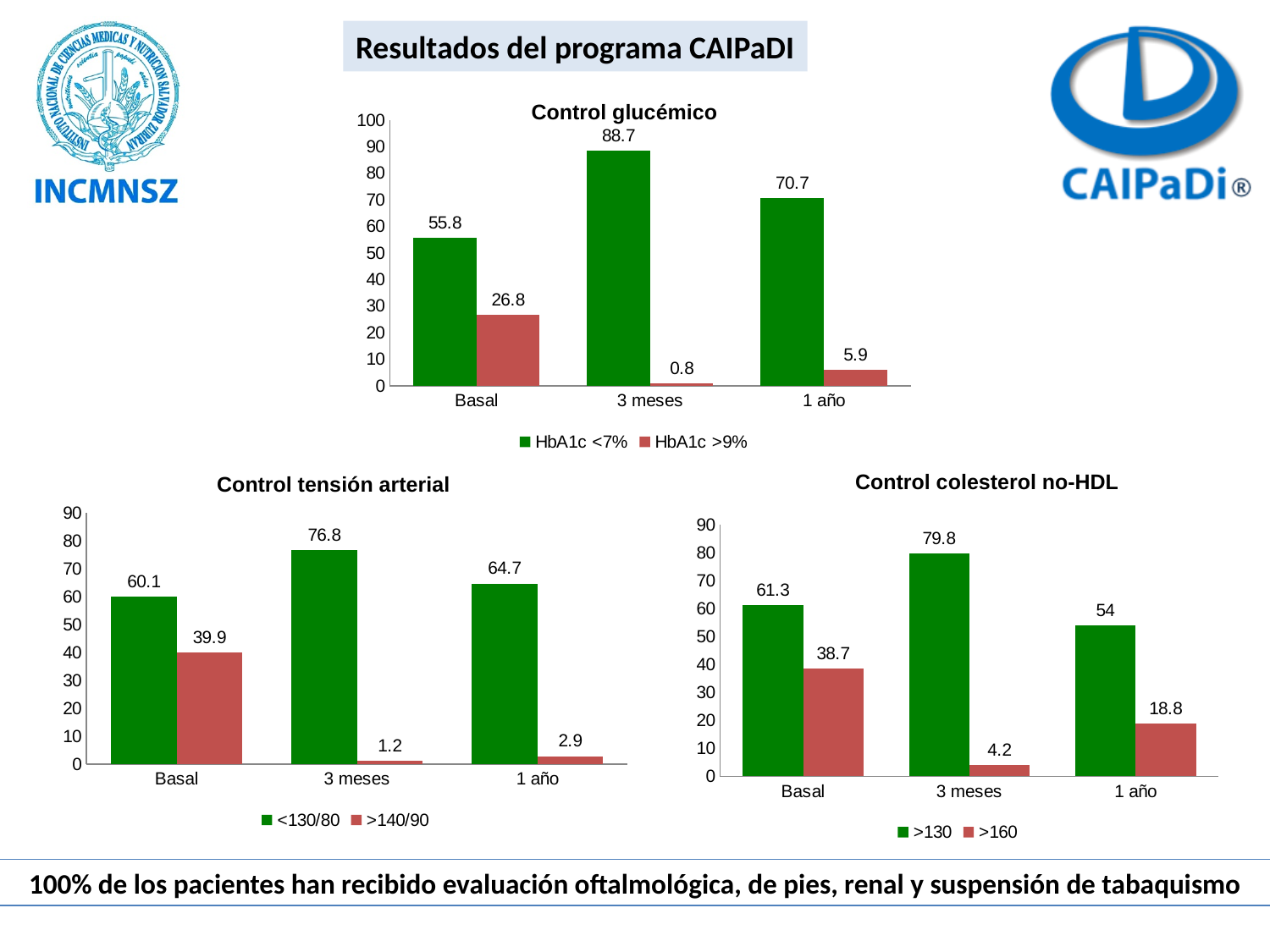
In the 'Control tensión arterial' chart, is the >140/90 value at Basal larger or smaller than the >140/90 value at 1 año? larger How many series does the legend of the 'Control colesterol no-HDL' chart list? 2 In the 'Control glucémico' chart, what is the value of HbA1c <7% at 3 meses? 88.7 In the 'Control tensión arterial' chart, which category has the highest <130/80 value? 3 meses In the 'Control tensión arterial' chart, what is the value of <130/80 at 1 año? 64.7 In the 'Control glucémico' chart, which category has the lowest HbA1c >9% value? 3 meses In the 'Control colesterol no-HDL' chart, what is the value of >130 at 1 año? 54 In the 'Control colesterol no-HDL' chart, what is the difference between the >160 values at Basal and 1 año? 19.9 In the 'Control glucémico' chart, what is the difference between the HbA1c <7% values at 3 meses and Basal? 32.9 What kind of chart is the 'Control tensión arterial' chart? Bar chart In the 'Control colesterol no-HDL' chart, what is the value of >160 at 3 meses? 4.2 In the 'Control glucémico' chart, what is the value of HbA1c >9% at Basal? 26.8